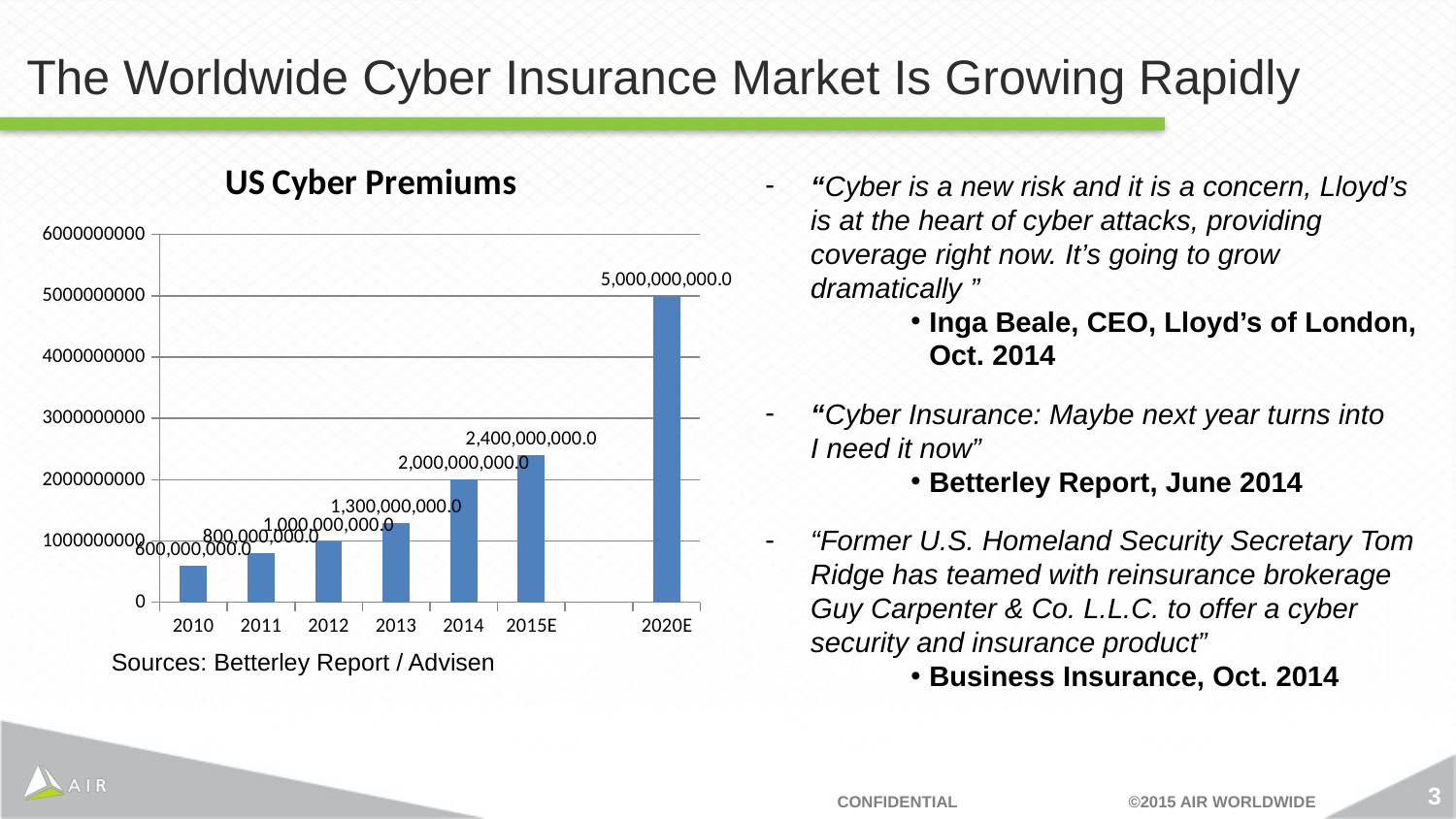
What kind of chart is the US Cyber Premiums chart? Bar chart What is the difference between the 2020E and 2015E values in the US Cyber Premiums chart? 2,600,000,000.0 What is the value for 2013 in the US Cyber Premiums chart? 1,300,000,000.0 What is the value for 2015E in the US Cyber Premiums chart? 2,400,000,000.0 Do the values in the US Cyber Premiums chart rise or fall from 2010 to 2020E? Rise Which year has the lowest value in the US Cyber Premiums chart? 2010 Which year has the highest value in the US Cyber Premiums chart? 2020E What is the value for 2020E in the US Cyber Premiums chart? 5,000,000,000.0 How many years are shown on the x axis of the US Cyber Premiums chart? 7 What is the value for 2014 in the US Cyber Premiums chart? 2,000,000,000.0 What is the difference between the 2014 and 2013 values in the US Cyber Premiums chart? 700,000,000.0 Which is larger in the US Cyber Premiums chart, the value for 2012 or the value for 2014? 2014